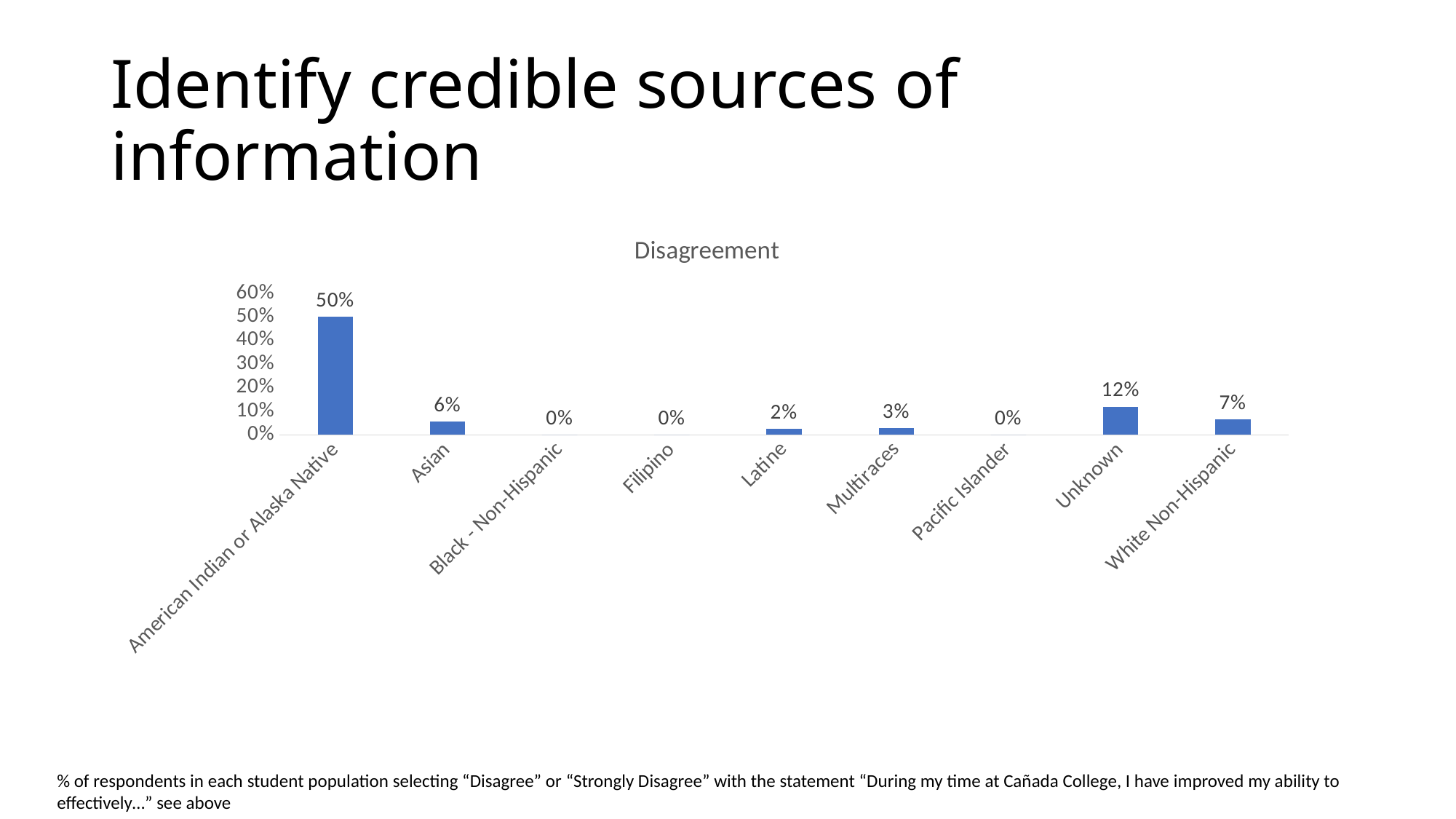
What is the difference between the disagreement values for American Indian or Alaska Native and Unknown? 38% Is the value for American Indian or Alaska Native greater or less than 40%? greater What is the disagreement value for Latine? 2% What is the disagreement value for White Non-Hispanic? 7% What is the title of the chart? Disagreement What is the difference between the disagreement values for Unknown and Asian? 6% Which is larger, the disagreement value for Asian or for White Non-Hispanic? White Non-Hispanic Which category has the highest disagreement value? American Indian or Alaska Native How many categories are shown on the x axis? 9 What is the disagreement value for Unknown? 12% What kind of chart is shown on the slide? Bar chart What is the disagreement value for American Indian or Alaska Native? 50%